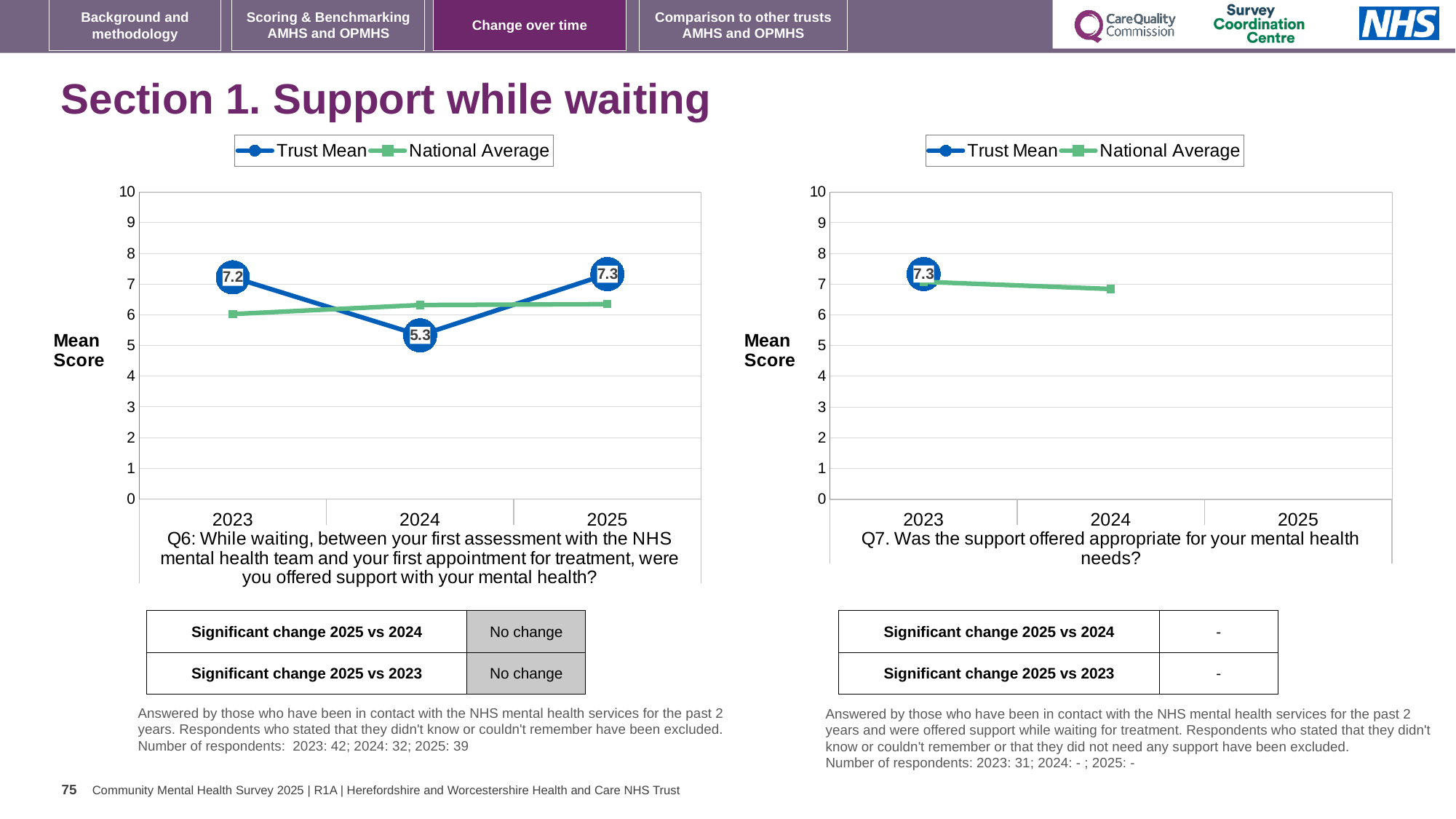
On the right chart (Q7), what is the Trust Mean score for 2023? 7.3 On the right chart (Q7), is the National Average for 2024 greater or less than 6? greater On the left chart (Q6), what is the Trust Mean score for 2025? 7.3 On the left chart (Q6), what is the Trust Mean score for 2024? 5.3 On the left chart (Q6), how many years are shown on the x axis? 3 On the left chart (Q6), what is the difference between the Trust Mean scores for 2025 and 2024? 2.0 What type of chart is used for Q7 on the right? line chart On the left chart (Q6), is the Trust Mean for 2024 higher or lower than the National Average for 2024? lower On the left chart (Q6), which year has the lowest Trust Mean score? 2024 On the left chart (Q6), is the National Average for 2023 greater or less than 7? less How many series does the legend of the left chart (Q6) list? 2 On the left chart (Q6), what is the Trust Mean score for 2023? 7.2